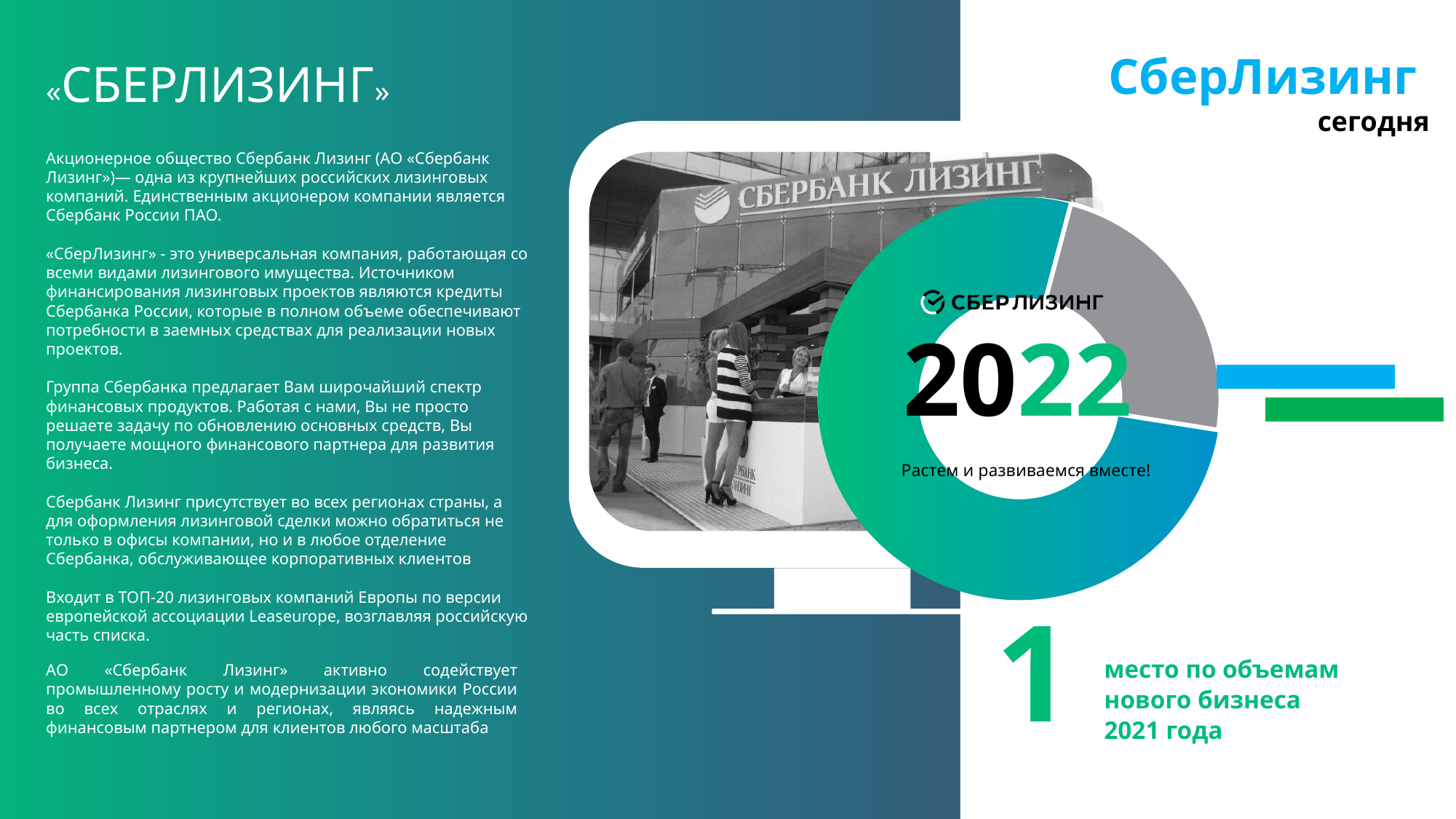
What text is shown in the centre of the donut chart? СБЕРЛИЗИНГ 2022 Растем и развиваемся вместе! Which colour slice of the donut chart is the largest? Green What kind of chart is shown on the slide? Pie (donut) chart How many slices does the donut chart on the slide have? 2 Does the donut chart on the slide display a legend? No